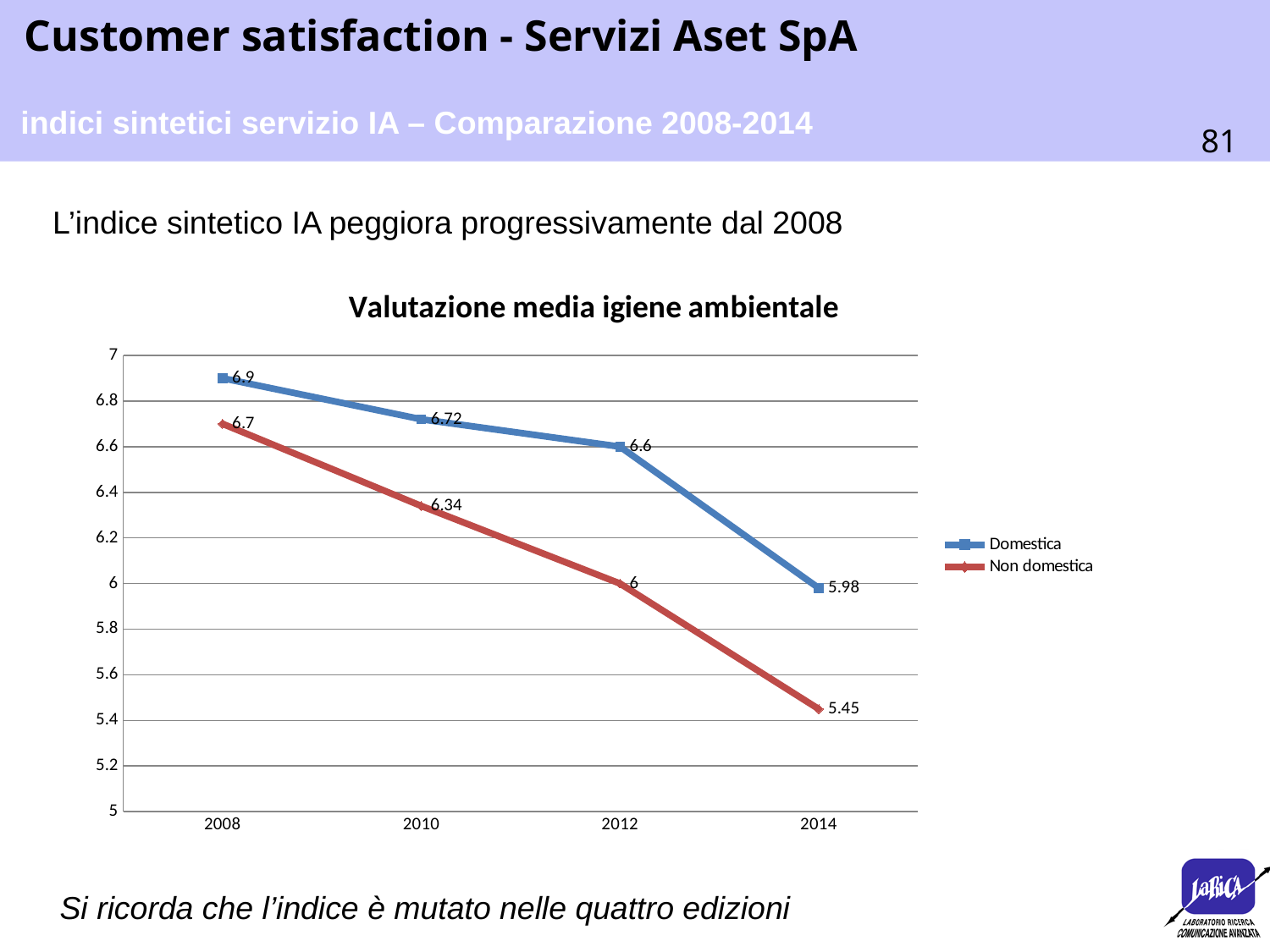
What is the value for Domestica in 2008? 6.9 What is the value for Domestica in 2014? 5.98 Which series has the larger value in 2010, Domestica or Non domestica? Domestica What is the value for Non domestica in 2010? 6.34 In which year is the Non domestica series lowest? 2014 What kind of chart is shown? Line chart What is the value for Non domestica in 2012? 6 What is the difference between Domestica and Non domestica in 2014? 0.53 Do the values for Domestica rise or fall from 2008 to 2014? Fall In which year is the Domestica series highest? 2008 How many years are shown on the x axis? 4 How many series does the legend list? 2